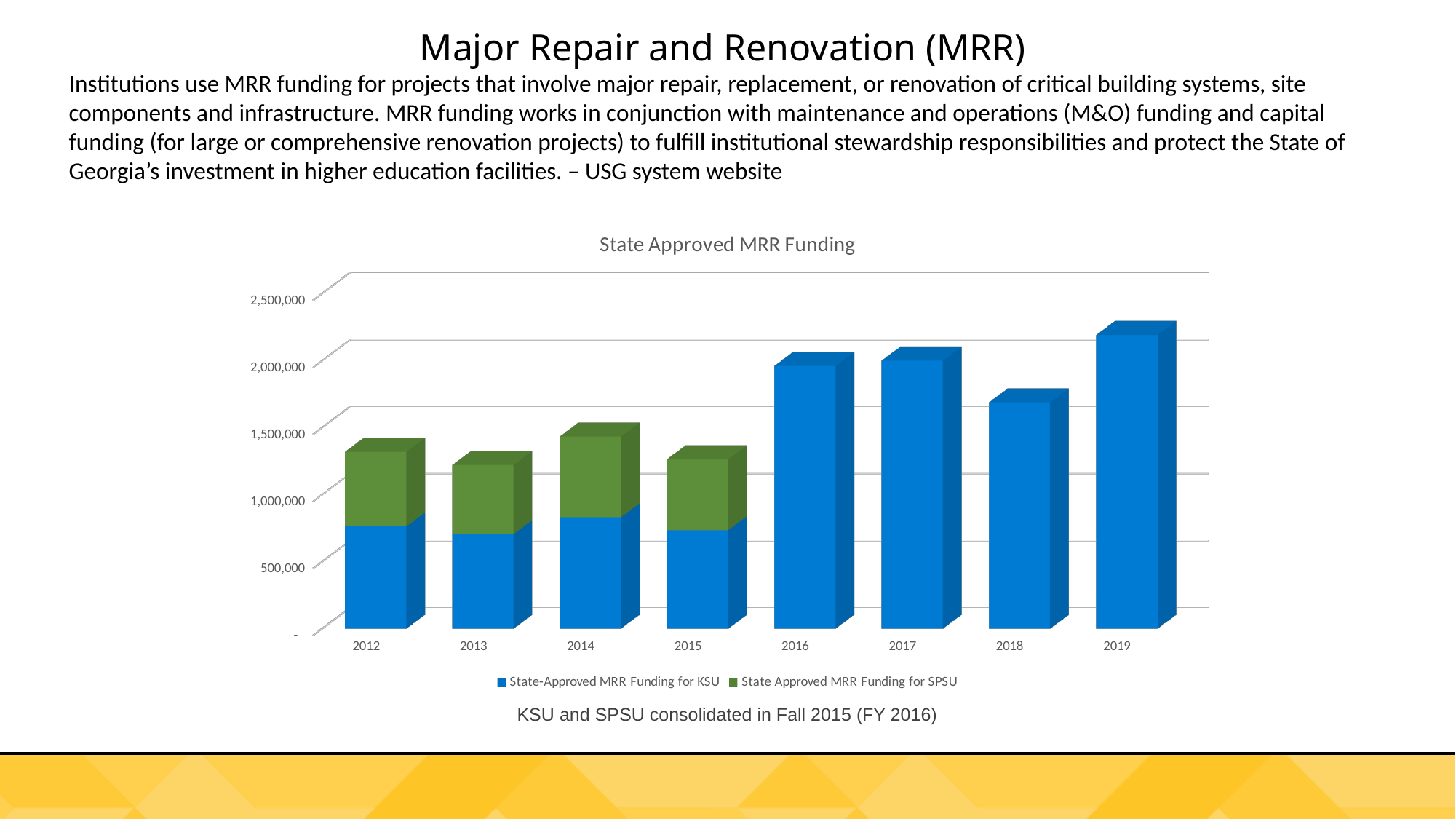
How many years are shown on the x axis of the chart? 8 Is the total State Approved MRR Funding for 2012 greater or less than 1,500,000? less Is the total State Approved MRR Funding for 2018 greater or less than 2,000,000? less Which colour represents State Approved MRR Funding for SPSU in the chart? green Is the total State Approved MRR Funding for 2019 greater or less than 2,000,000? greater Which year has the larger total State Approved MRR Funding, 2015 or 2016? 2016 What type of chart is shown on the slide? bar chart How many series does the chart legend list? 2 What is the title of the chart? State Approved MRR Funding Which year has the highest total State Approved MRR Funding? 2019 Which year has the larger total State Approved MRR Funding, 2018 or 2019? 2019